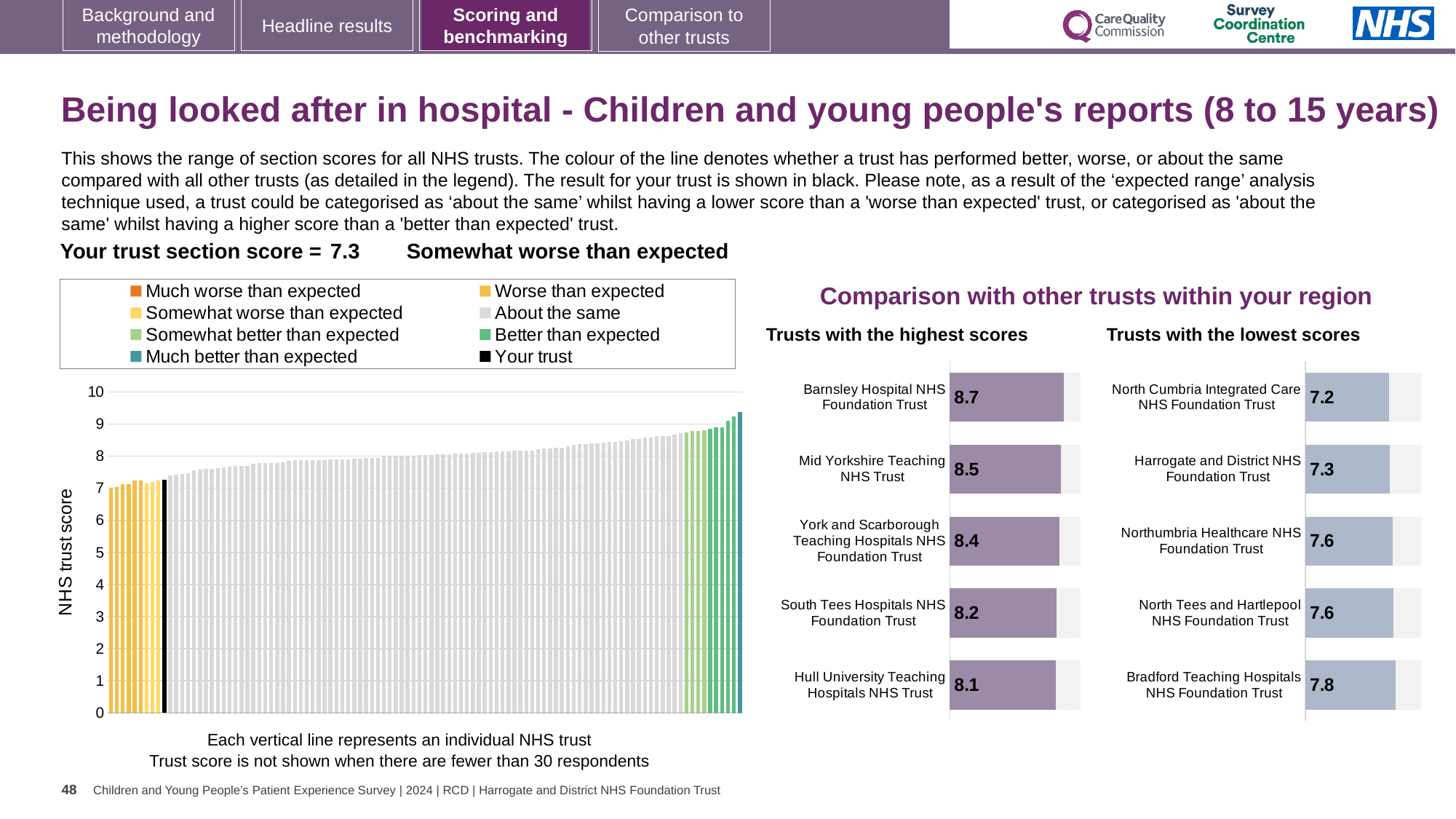
In the 'Trusts with the highest scores' chart, what is the difference between the scores of Barnsley Hospital NHS Foundation Trust and South Tees Hospitals NHS Foundation Trust? 0.5 In the 'Trusts with the lowest scores' chart, which is larger: the score for North Cumbria Integrated Care NHS Foundation Trust or Northumbria Healthcare NHS Foundation Trust? Northumbria Healthcare NHS Foundation Trust In the 'Trusts with the lowest scores' chart, what is the score for Harrogate and District NHS Foundation Trust? 7.3 In the 'Trusts with the highest scores' chart, what is the score for York and Scarborough Teaching Hospitals NHS Foundation Trust? 8.4 In the 'Trusts with the highest scores' chart, what is the score for Barnsley Hospital NHS Foundation Trust? 8.7 In the large chart on the left, do the trust scores rise or fall from left to right? Rise In the large chart on the left, is the value of the black bar (your trust) greater or less than 8? less In the 'Trusts with the highest scores' chart, which trust has the lowest score? Hull University Teaching Hospitals NHS Trust What kind of chart is the large chart on the left showing NHS trust scores? Bar chart In the 'Trusts with the lowest scores' chart, which trust has the highest score? Bradford Teaching Hospitals NHS Foundation Trust How many trusts are shown in the 'Trusts with the lowest scores' chart? 5 How many entries does the legend of the large chart on the left list? 8